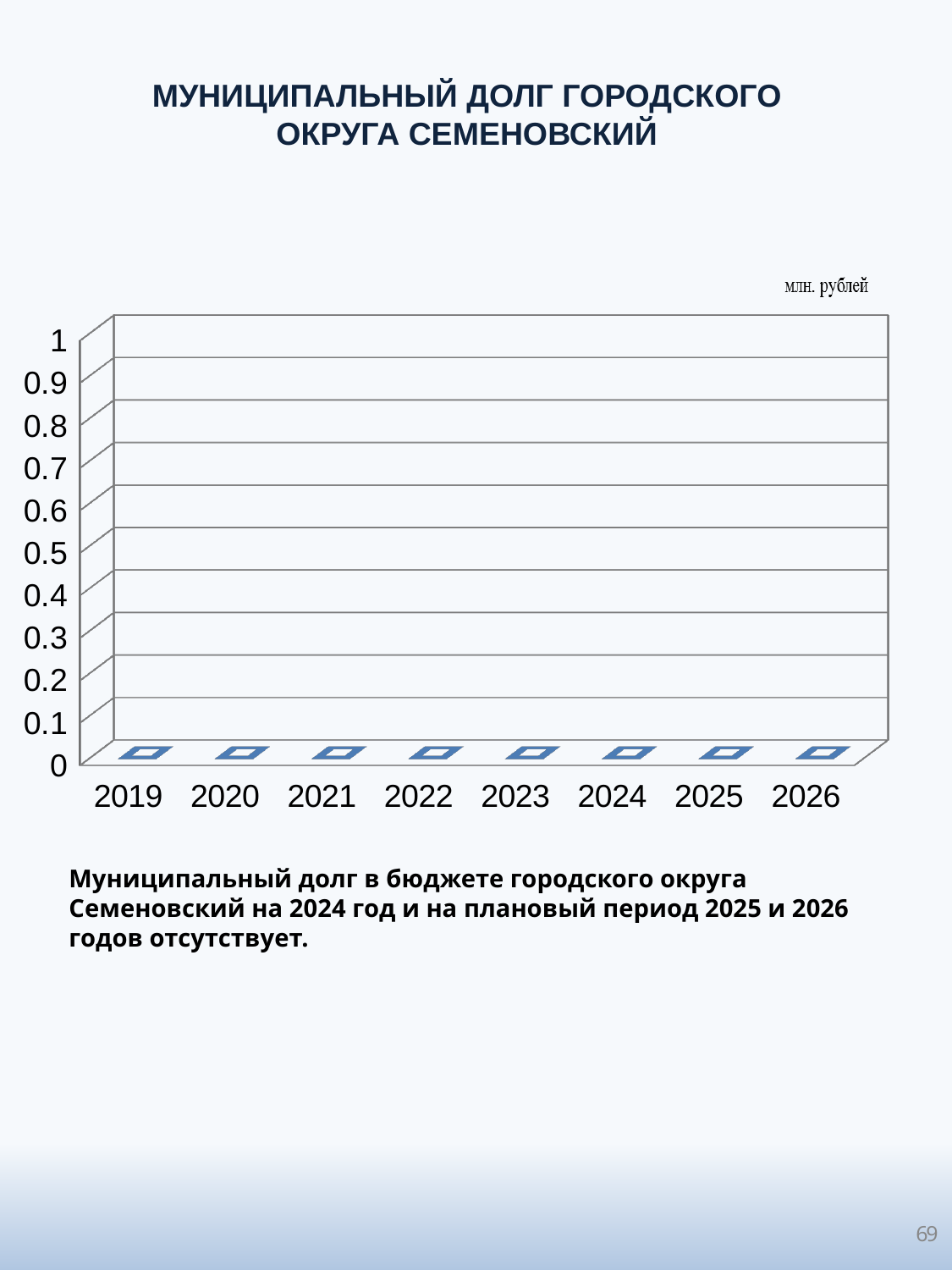
Is the value for 2022 greater or less than 0.1? less What is the value for 2026 on the chart? 0 What is the first year shown on the x axis? 2019 What is the value for 2024 on the chart? 0 Do the values rise, fall, or stay the same from 2019 to 2026? stay the same Is the value for 2025 greater or less than 0.5? less What is the value for 2019 on the chart? 0 How many years are shown on the x axis of the chart? 8 What unit is indicated above the chart? млн. рублей What kind of chart is shown on the slide? bar chart What is the difference between the values for 2023 and 2020? 0